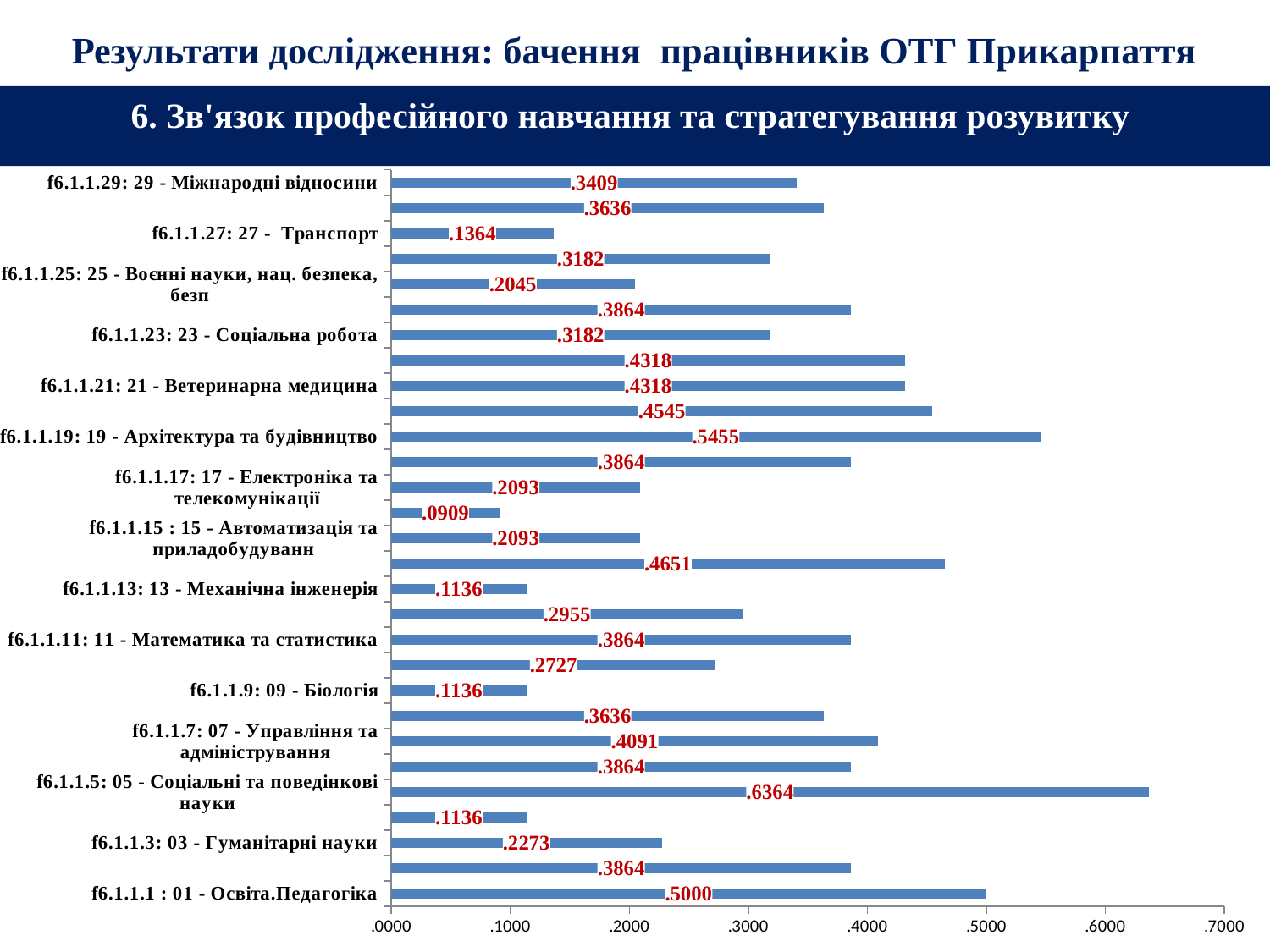
What kind of chart is shown on the slide? bar chart What is the difference between the values for f6.1.1.5: 05 - Соціальні та поведінкові науки and f6.1.1.1 : 01 - Освіта.Педагогіка? .1364 What is the smallest value shown on the chart? .0909 Which category has the highest value? f6.1.1.5: 05 - Соціальні та поведінкові науки What is the value for f6.1.1.1 : 01 - Освіта.Педагогіка? .5000 Which is larger: the value for f6.1.1.25: 25 - Воєнні науки, нац. безпека, безп or for f6.1.1.27: 27 - Транспорт? f6.1.1.25: 25 - Воєнні науки, нац. безпека, безп How many bars are plotted on the chart? 29 What is the value for f6.1.1.23: 23 - Соціальна робота? .3182 What is the title shown in the blue band above the chart? 6. Зв'язок професійного навчання та стратегування розувитку Is the value for f6.1.1.29: 29 - Міжнародні відносини greater or less than .3000? greater What is the value for f6.1.1.27: 27 - Транспорт? .1364 What is the value for f6.1.1.19: 19 - Архітектура та будівництво? .5455